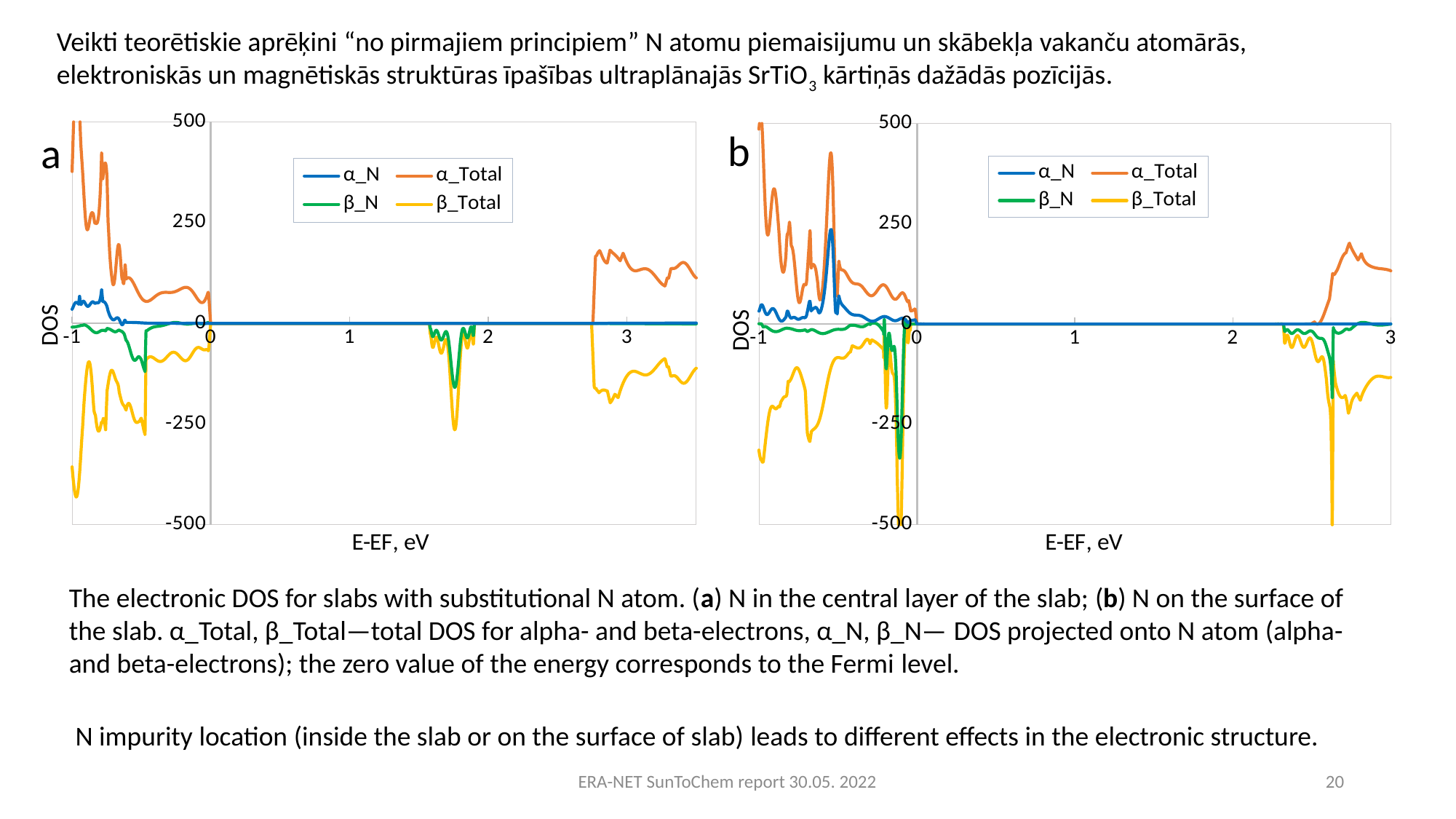
In chart a (the left chart), is the value of α_Total at E-EF = 3 eV greater or less than 250? less In chart b (the right chart), is the lowest value reached by β_Total greater or less than -250? less In chart b (the right chart), at E-EF = -1 eV, which is larger: the value of α_Total or the value of α_N? α_Total In chart a (the left chart), which series reaches the highest value on the DOS axis? α_Total What kind of chart is chart a (the left chart)? line chart How many series does the legend of chart b (the right chart) list? 4 In chart a (the left chart), is the value of α_Total at E-EF = -1 eV greater or less than 250? greater In chart a (the left chart), what is the label of the x axis? E-EF, eV In chart b (the right chart), what is the label of the y axis? DOS In chart b (the right chart), which series reaches the lowest value on the DOS axis? β_Total